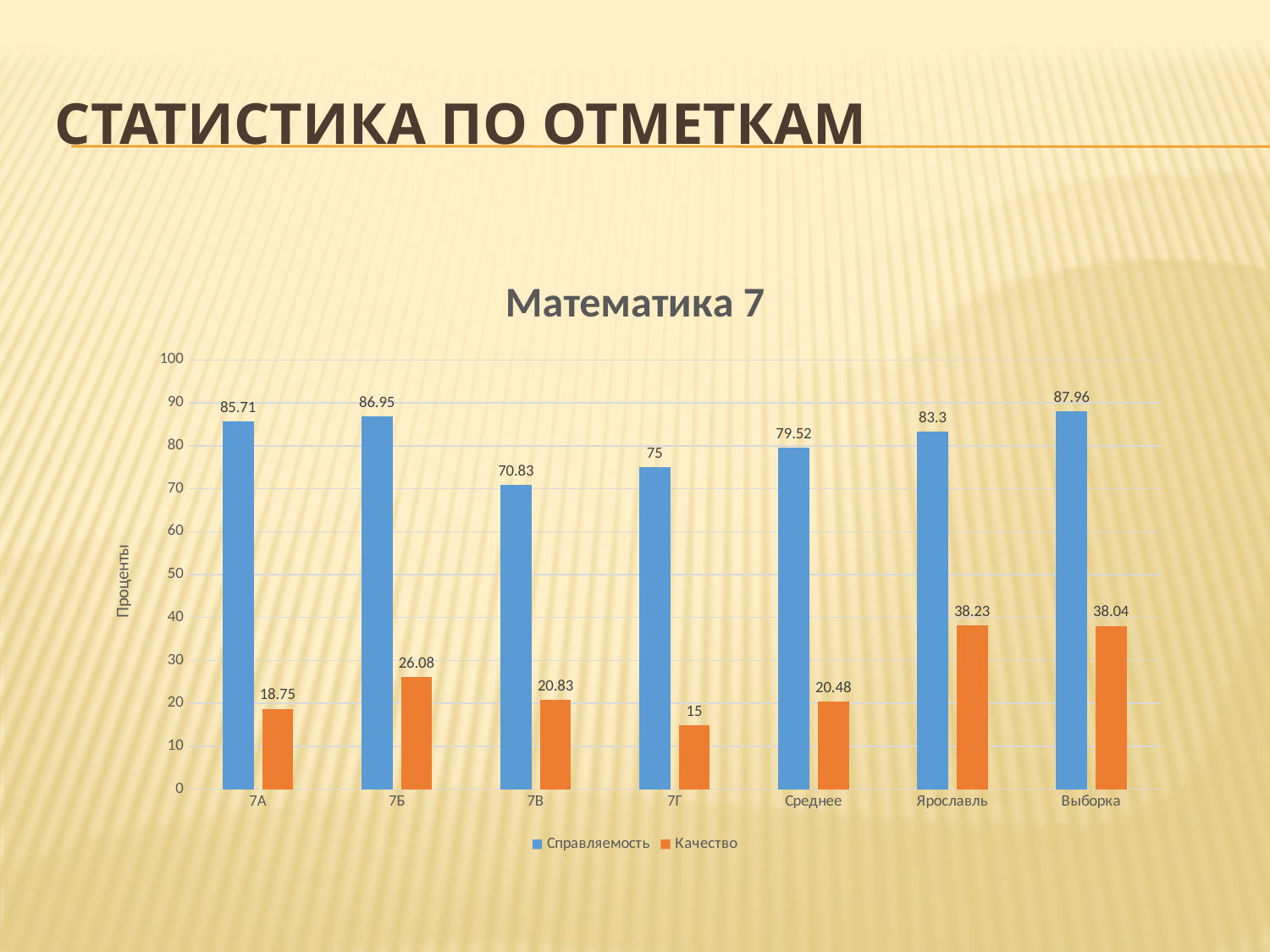
How many series does the legend list? 2 Which is larger, the Качество value for 7Б or for 7В? 7Б What is the title of the chart? Математика 7 Which category has the highest Справляемость value? Выборка Is the Справляемость value for 7Г greater or less than 80? less What is the Справляемость value for 7Б? 86.95 What is the Справляемость value for Среднее? 79.52 Which category has the lowest Справляемость value? 7В Which category has the lowest Качество value? 7Г What is the Качество value for Ярославль? 38.23 How many categories are shown on the x axis? 7 What is the difference between the Справляемость and Качество values for 7А? 66.96